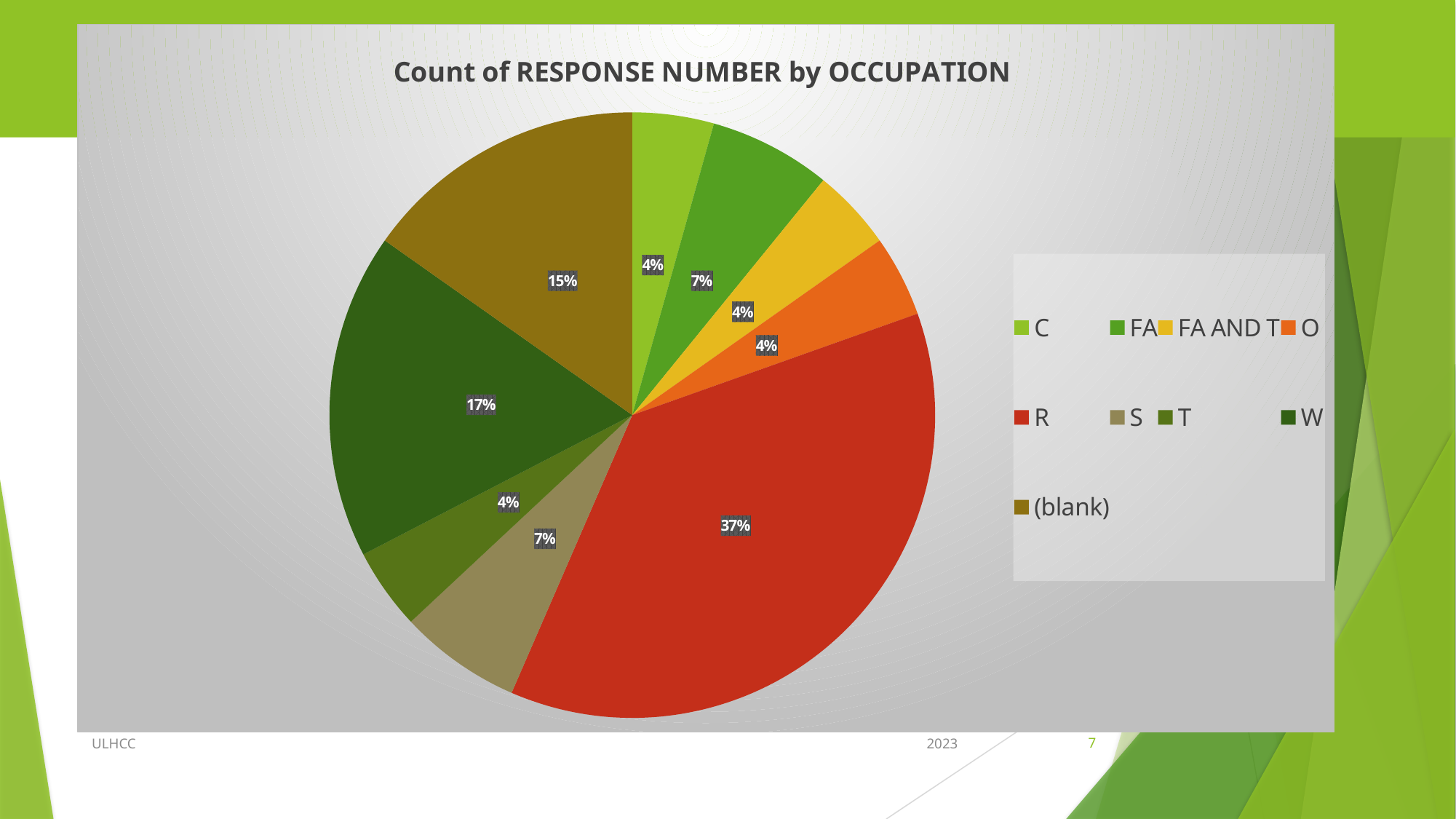
What share of the pie does (blank) represent? 15% What share of the pie does W represent? 17% What is the title of the chart? Count of RESPONSE NUMBER by OCCUPATION What kind of chart is shown on the slide? pie chart What share of the pie does FA represent? 7% Which is larger, the slice for W or the slice for (blank)? W What is the difference in percentage points between the R slice and the W slice? 20 Which category is shown in red on the chart? R How many categories does the legend list? 9 Which category has the largest slice of the pie? R